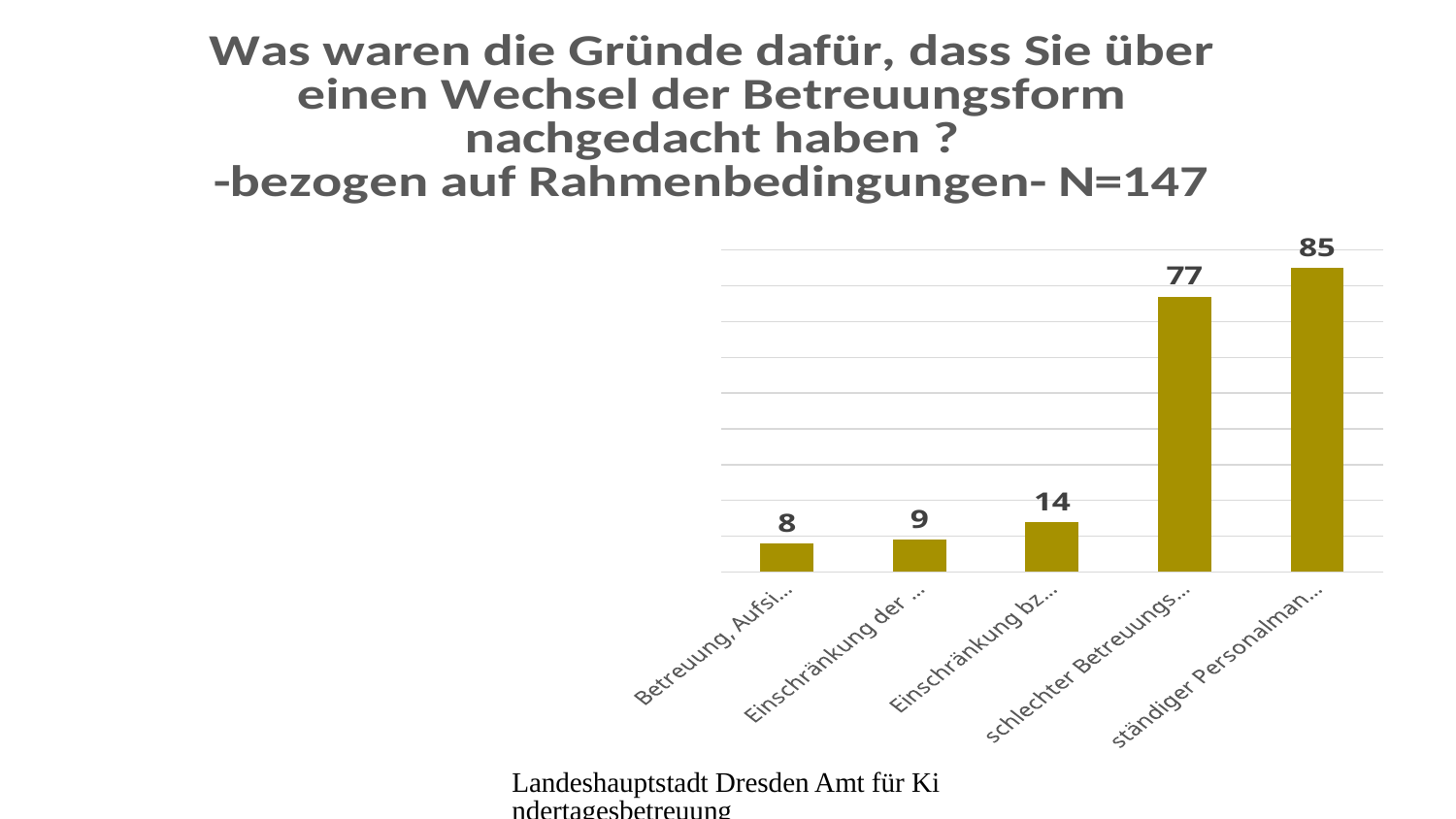
What is the value of the bar labelled "Einschränkung bz..."? 14 What kind of chart is shown on the slide? bar chart How many categories are shown in the chart? 5 Which category has the highest value? ständiger Personalman... What is the value of the bar labelled "schlechter Betreuungs..."? 77 What is the difference between the values for "ständiger Personalman..." and "schlechter Betreuungs..."? 8 Which category has the lowest value? Betreuung, Aufsi... Which is larger, the value for "schlechter Betreuungs..." or the value for "Einschränkung bz..."? schlechter Betreuungs... What is the difference between the values for "Einschränkung bz..." and "Einschränkung der ..."? 5 What is the value of the bar labelled "ständiger Personalman..."? 85 What is the value of the bar labelled "Betreuung, Aufsi..."? 8 What is the N value stated in the chart title? N=147